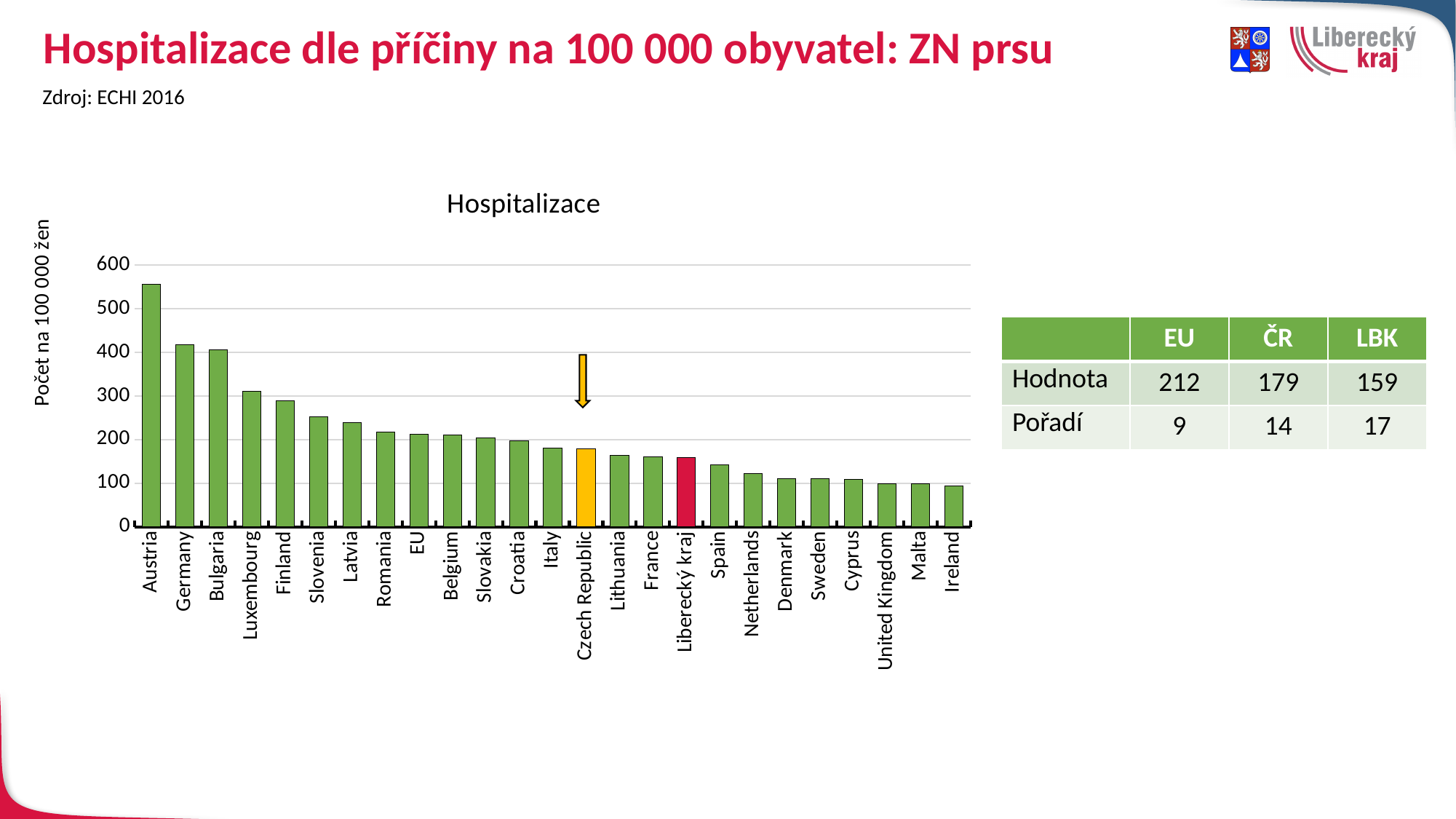
What is the title of the chart? Hospitalizace What is the value for Liberecký kraj (LBK) according to the slide? 159 Do the values rise or fall from left to right along the x axis? Fall Is the value for Spain greater or less than 200? less What is the value for EU according to the slide? 212 What is the value for Czech Republic (ČR) according to the slide? 179 Which category has the highest value in the chart? Austria How many categories (bars) are shown on the x axis of the chart? 25 Which has a larger value, Finland or Slovenia? Finland Is the value for Austria greater or less than 500? greater What type of chart is shown on the slide? Bar chart What is the difference between the EU value and the ČR value? 33